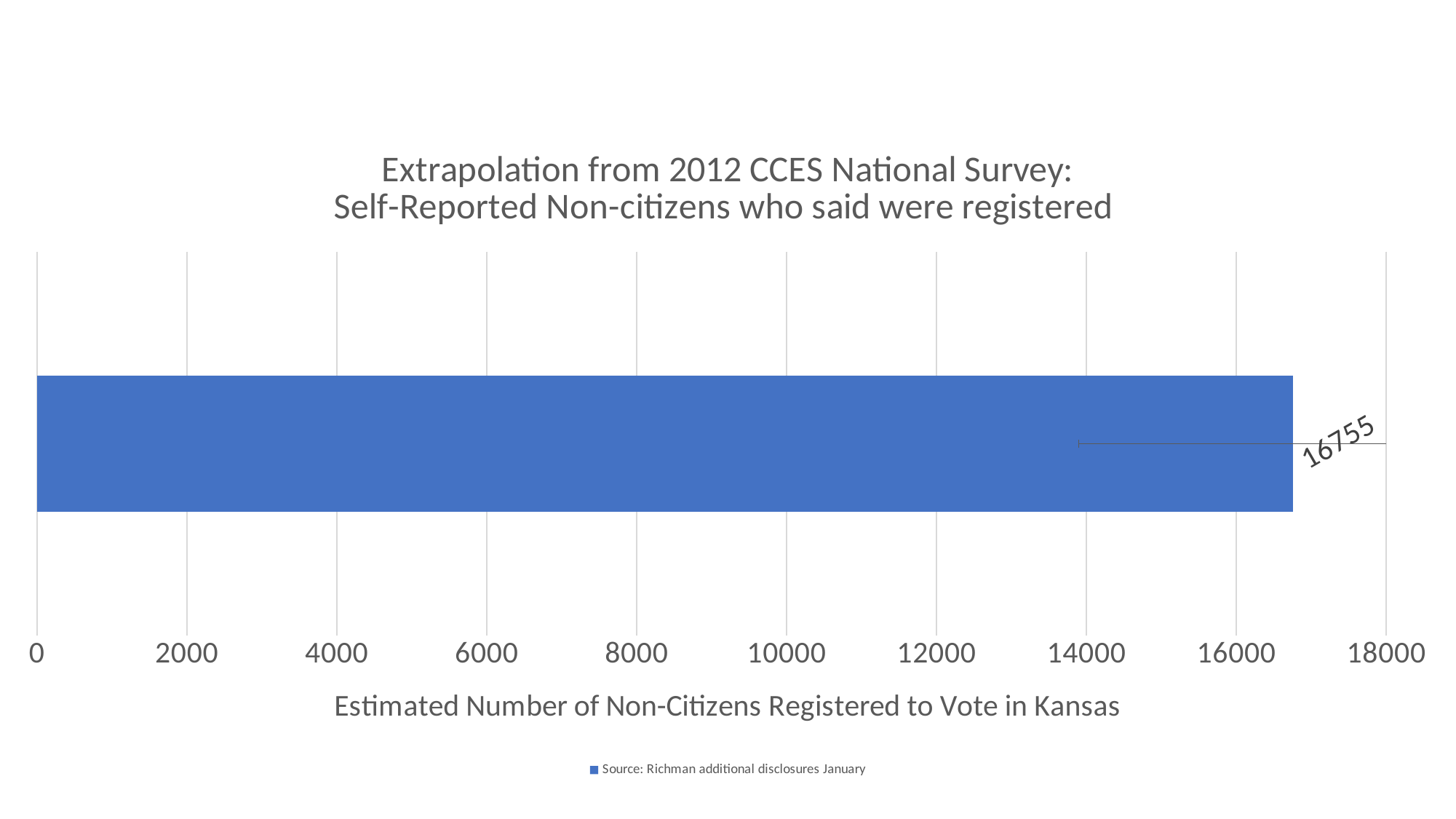
How many series does the legend list? 1 Is the value of the bar greater or less than 18000? less How many bars are plotted in the chart? 1 What is the label of the horizontal axis? Estimated Number of Non-Citizens Registered to Vote in Kansas Is the value of the bar greater or less than 16000? greater What kind of chart is shown on the slide? bar chart What is the estimated number of non-citizens registered to vote in Kansas according to the chart? 16755 What is the maximum value shown on the horizontal axis? 18000 What is the value shown by the data label on the bar? 16755 What is the title of the chart? Extrapolation from 2012 CCES National Survey: Self-Reported Non-citizens who said were registered